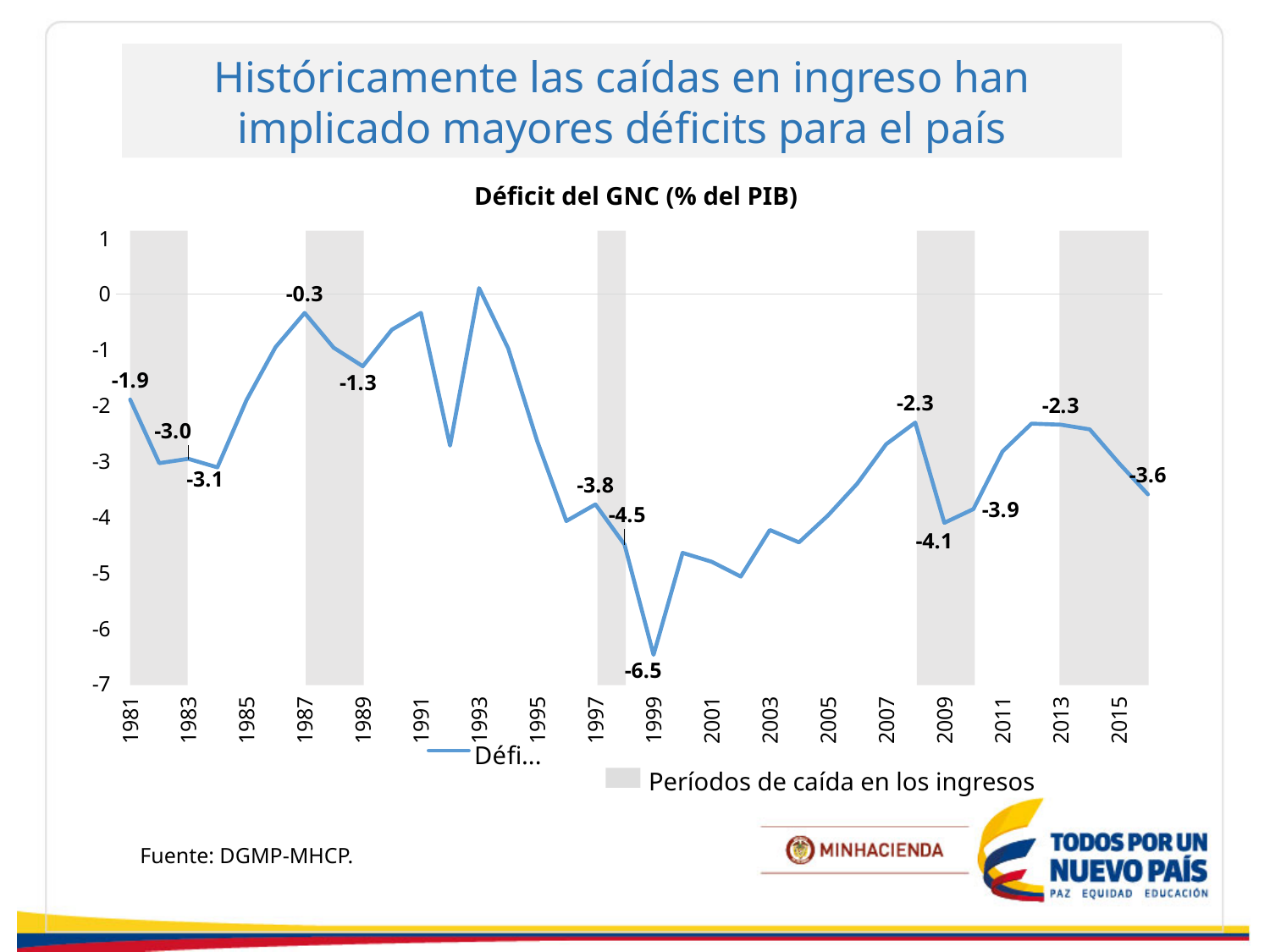
Is the value for 2001 greater or less than -4? less How many shaded periods of falling income are marked on the chart? 5 What is the deficit value labelled for 2009? -4.1 What is the difference between the labelled values for 1987 and 1999? 6.2 What is the deficit value labelled for 1989? -1.3 Which year has the lowest deficit value on the chart? 1999 What is the deficit value labelled for 1987? -0.3 What type of chart is shown on the slide? Line chart What is the deficit value labelled for 1981? -1.9 What is the title of the chart? Déficit del GNC (% del PIB) Is the value for 1993 greater or less than -1? greater What is the deficit value labelled for 1999? -6.5